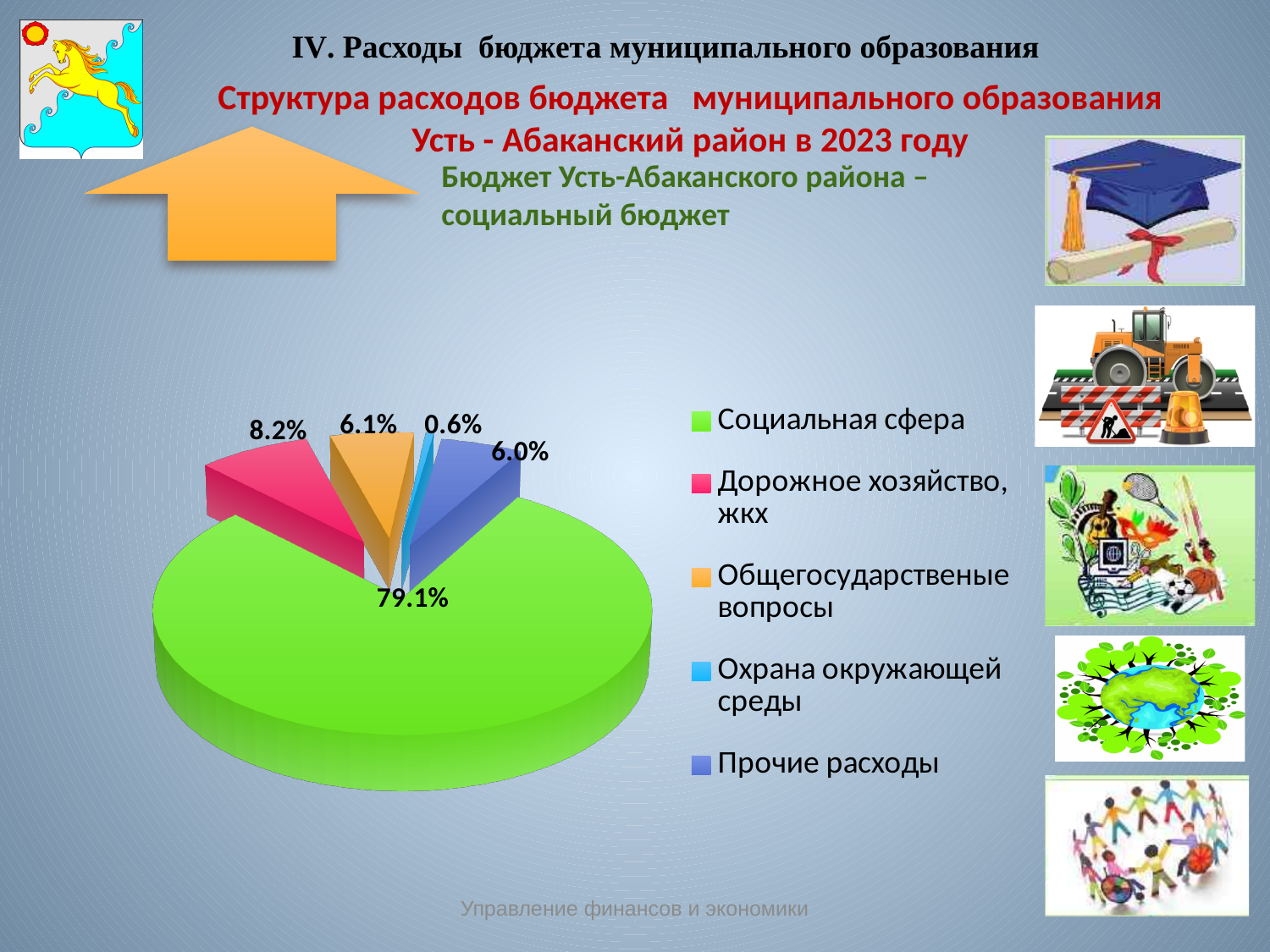
Which category has the largest share of the pie? Социальная сфера How many categories does the legend list? 5 What is the value for Охрана окружающей среды? 0.6% What kind of chart is shown on the slide? pie chart Which is larger: the share for Дорожное хозяйство, жкх or the share for Прочие расходы? Дорожное хозяйство, жкх What share of the budget expenditure goes to Социальная сфера? 79.1% What is the value for Общегосударственые вопросы? 6.1% What colour is the slice for Социальная сфера? green Which category has the smallest share of the pie? Охрана окружающей среды What is the difference between the shares of Социальная сфера and Дорожное хозяйство, жкх? 70.9% What is the value for Прочие расходы? 6.0% What is the value for Дорожное хозяйство, жкх? 8.2%